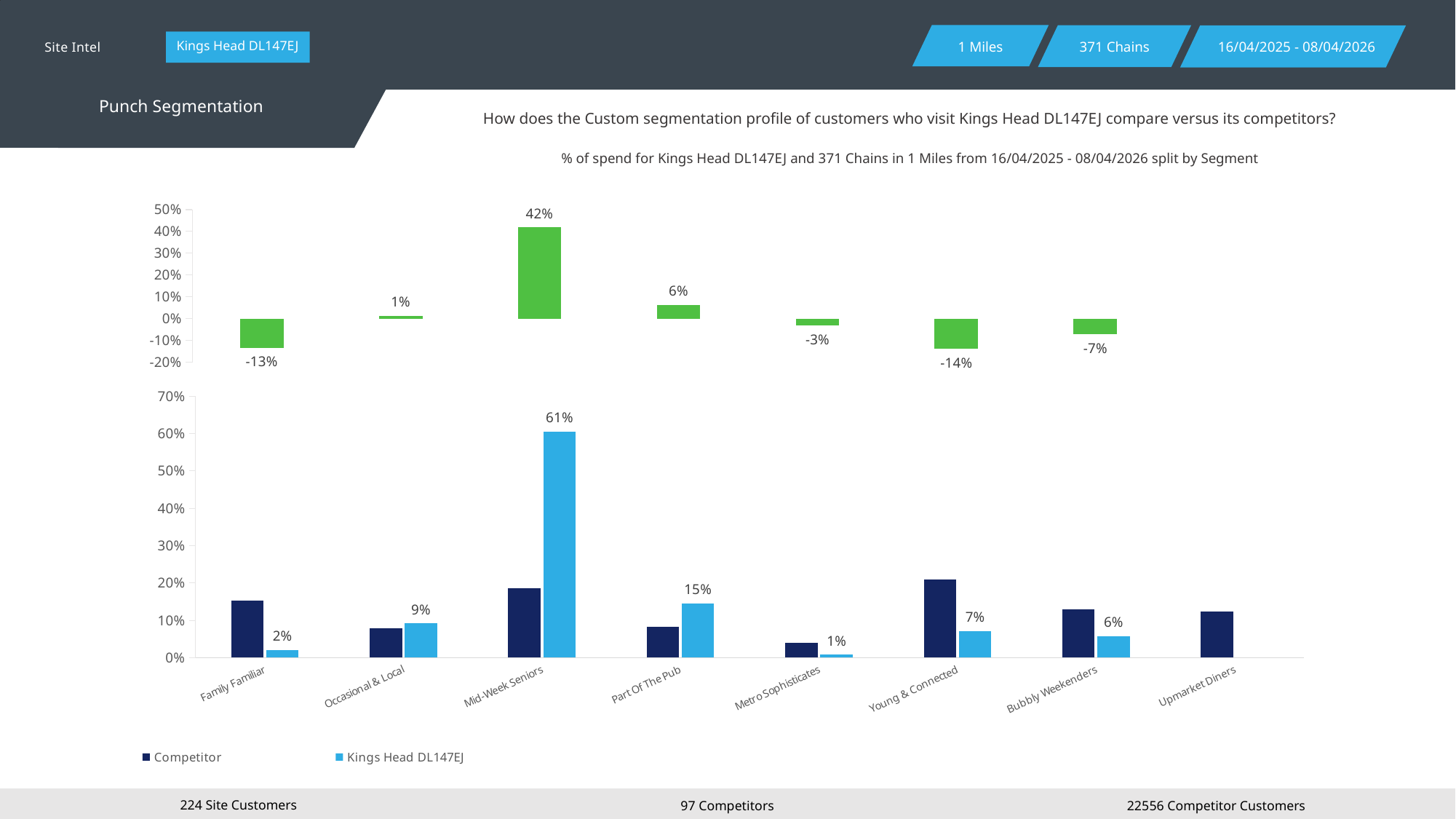
In the bottom chart, what is the difference between the Kings Head DL147EJ values for Occasional & Local and Family Familiar? 7% In the bottom chart, what is the value for Kings Head DL147EJ in the Part Of The Pub segment? 15% In the top chart, what is the value shown for Young & Connected? -14% In the top chart, which segment has the lowest value? Young & Connected In the bottom chart, what is the value for Kings Head DL147EJ in the Mid-Week Seniors segment? 61% How many segments are shown on the x axis of the bottom chart? 8 How many series does the legend of the bottom chart list? 2 What type of chart is the bottom chart? Bar chart In the bottom chart, which segment has the highest Kings Head DL147EJ value? Mid-Week Seniors In the bottom chart, which is larger for Young & Connected: the Competitor value or the Kings Head DL147EJ value? Competitor In the bottom chart, is the Competitor value for Metro Sophisticates greater or less than 10%? less